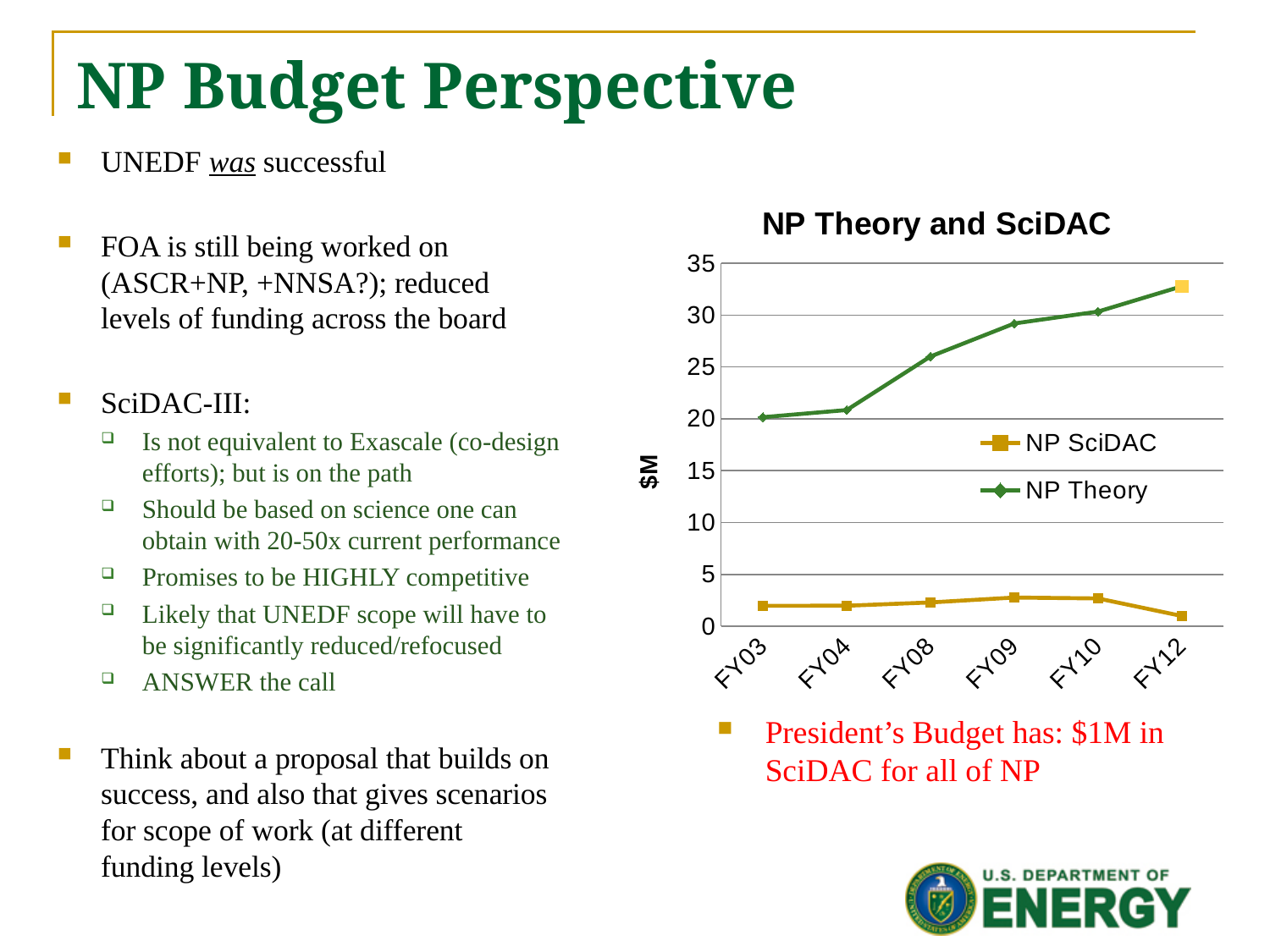
In which fiscal year is the NP Theory value highest? FY12 In which fiscal year is the NP SciDAC value lowest? FY12 Is the NP Theory value for FY03 greater or less than 25? less Is the NP SciDAC value for FY09 greater or less than 5? less How many series does the chart legend list? 2 What is the label on the y axis of the chart? $M At FY12, which series has the larger value, NP Theory or NP SciDAC? NP Theory Is the NP Theory value for FY12 greater or less than 30? greater Does the NP Theory series rise or fall from FY03 to FY12? rise How many fiscal years are plotted along the x axis of the chart? 6 What kind of chart is shown on the slide? line chart What is the title of the chart? NP Theory and SciDAC